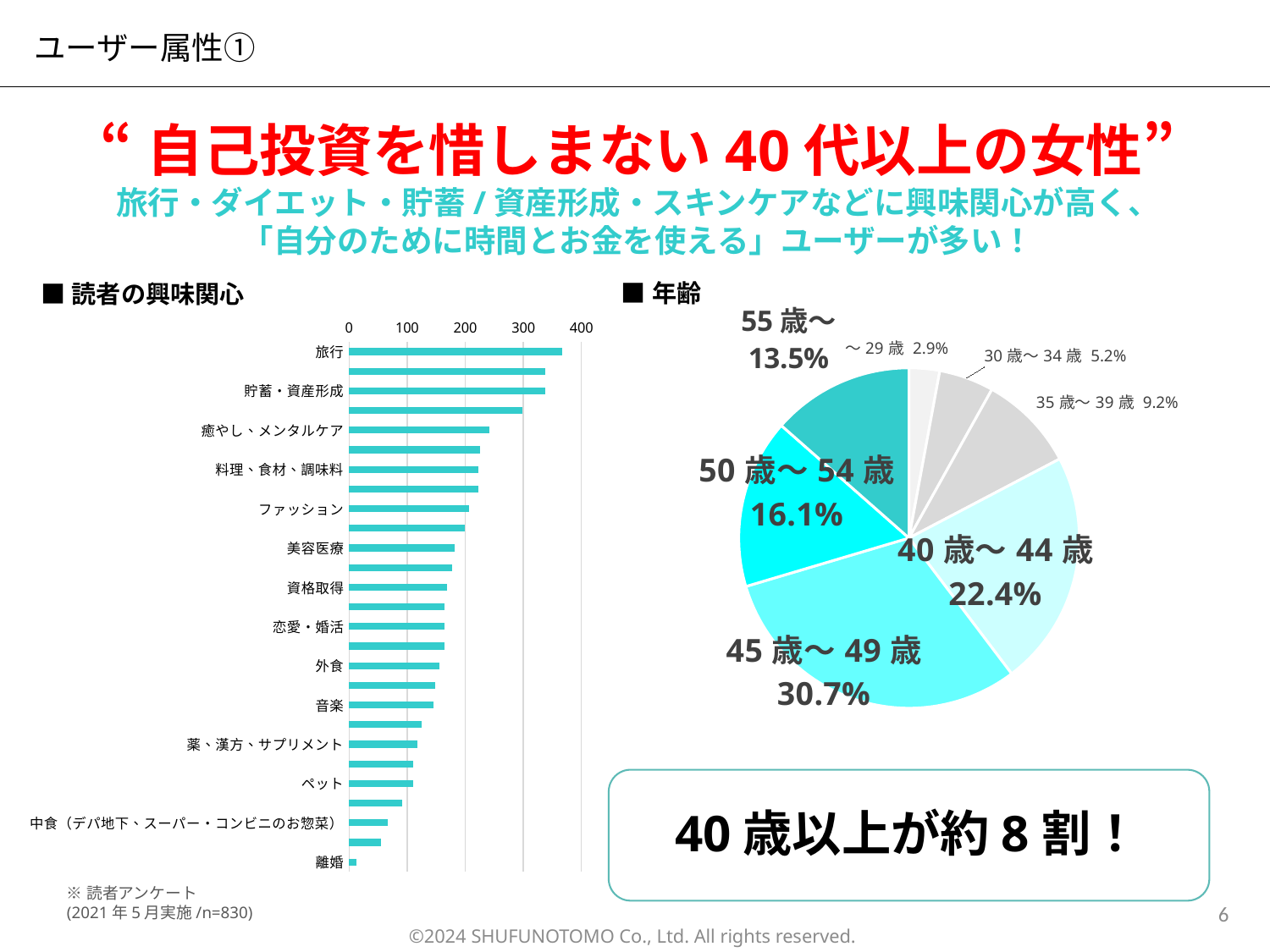
In the 年齢 pie chart, how many percentage points larger is 45歳～49歳 than 40歳～44歳? 8.3 In the 読者の興味関心 bar chart, which category has the longest bar? 旅行 In the 年齢 pie chart, which is larger: 50歳～54歳 or 55歳～? 50歳～54歳 In the 読者の興味関心 bar chart, is the value for 旅行 greater or less than 300? greater In the 年齢 pie chart, which age group has the largest share? 45歳～49歳 In the 年齢 pie chart, which age group has the smallest share? ～29歳 How many slices does the 年齢 pie chart have? 7 In the 読者の興味関心 bar chart, is the value for 離婚 greater or less than 100? less In the 年齢 pie chart, what share is 55歳～? 13.5% In the 年齢 pie chart, what share is 40歳～44歳? 22.4% What kind of chart is the 読者の興味関心 chart? bar chart In the 年齢 pie chart, what share is 45歳～49歳? 30.7%